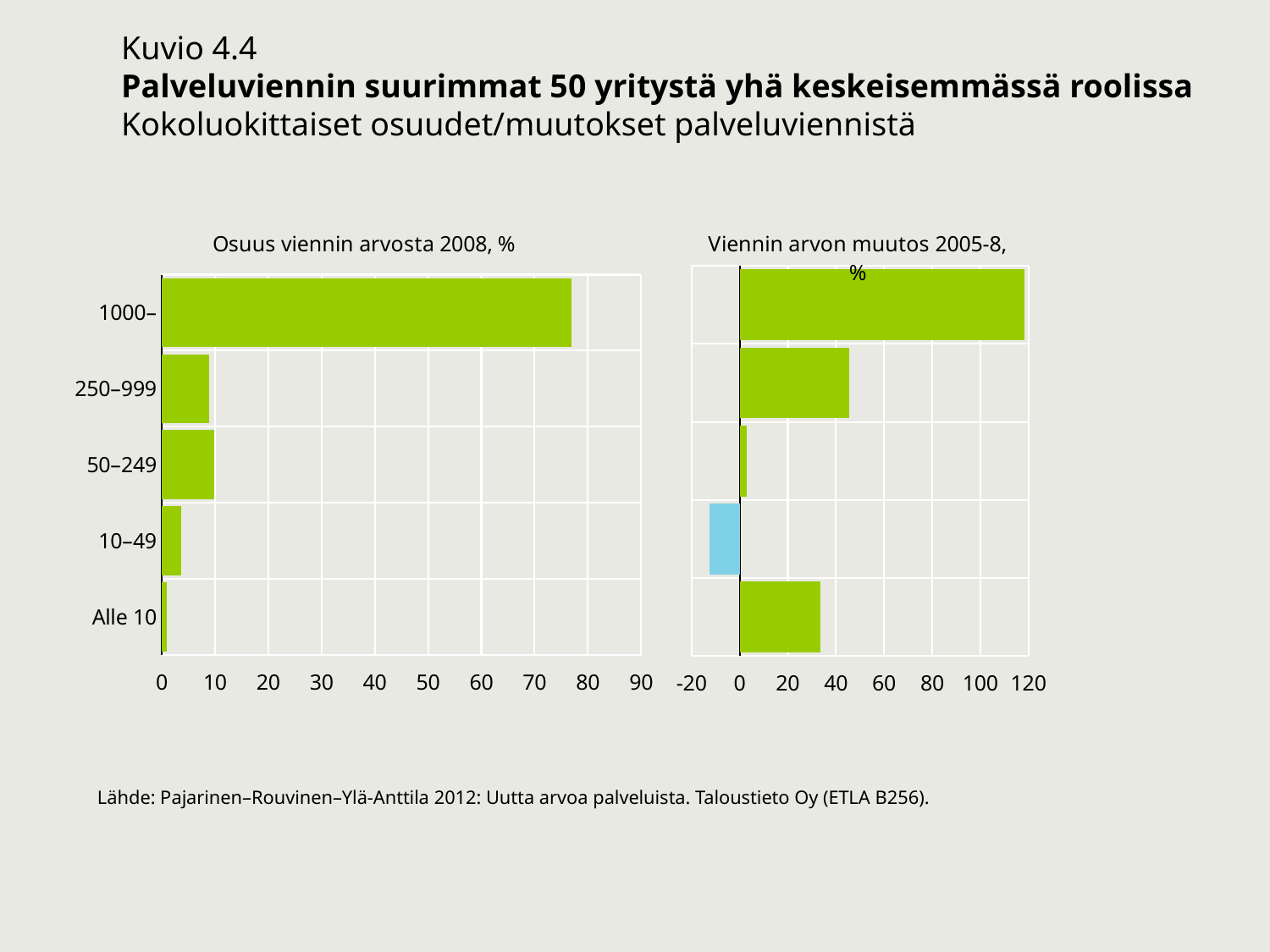
In the right chart "Viennin arvon muutos 2005-8, %", which category has the lowest value? 10–49 In the left chart "Osuus viennin arvosta 2008, %", is the value for 10–49 greater or less than 10? less In the right chart "Viennin arvon muutos 2005-8, %", which category has the highest value? 1000– In the right chart "Viennin arvon muutos 2005-8, %", is the value for 250–999 greater or less than 40? greater What kind of chart is the left chart titled "Osuus viennin arvosta 2008, %"? bar chart In the right chart "Viennin arvon muutos 2005-8, %", which category's bar is coloured blue instead of green? 10–49 How many size categories are shown on the left chart "Osuus viennin arvosta 2008, %"? 5 In the right chart "Viennin arvon muutos 2005-8, %", which is larger, the value for 250–999 or the value for Alle 10? 250–999 In the left chart "Osuus viennin arvosta 2008, %", which category has the lowest value? Alle 10 In the right chart "Viennin arvon muutos 2005-8, %", is the value for 10–49 greater or less than 0? less In the left chart "Osuus viennin arvosta 2008, %", which category has the highest value? 1000–